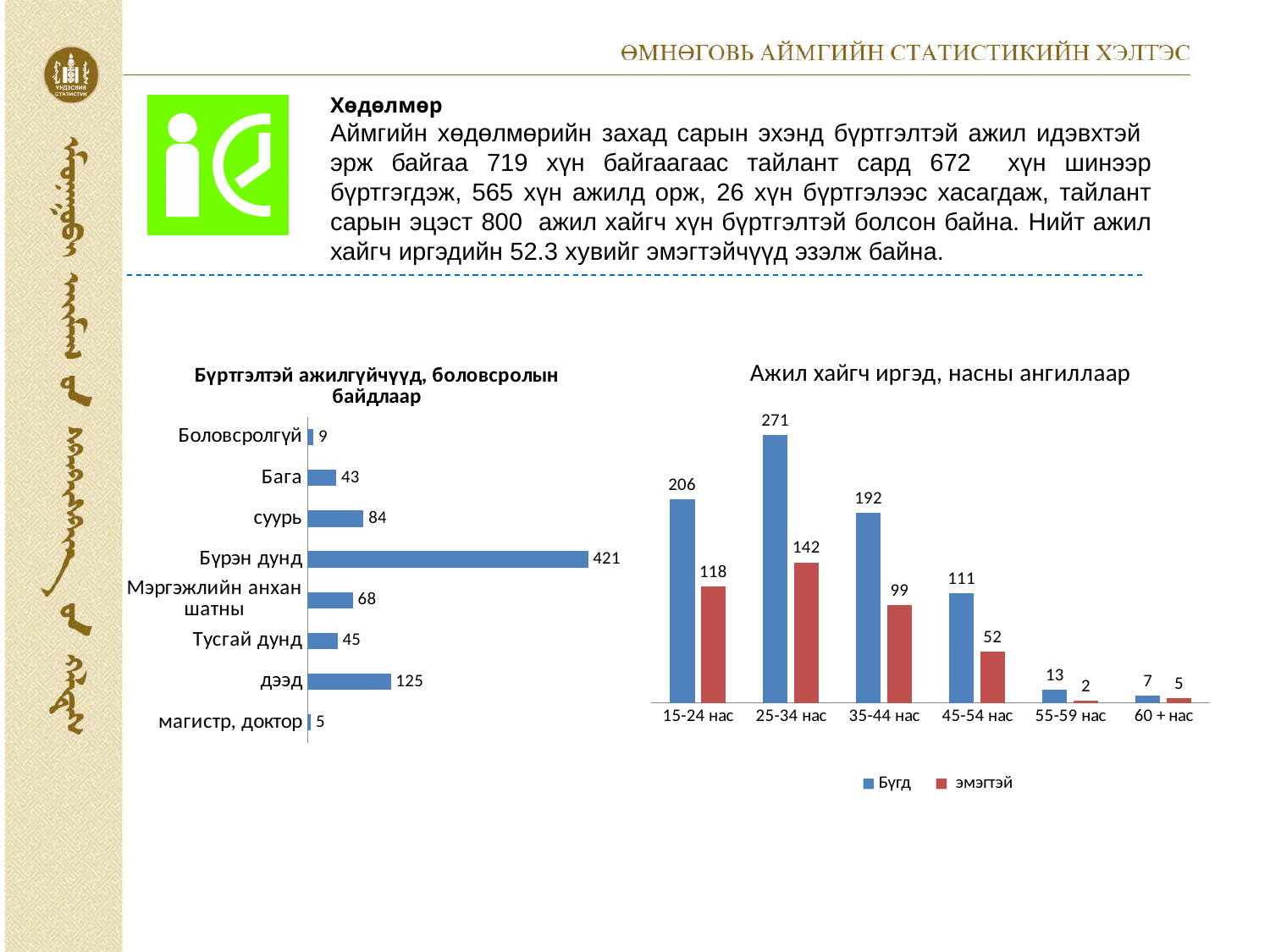
In the chart 'Бүртгэлтэй ажилгүйчүүд, боловсролын байдлаар', what is the value for Бүрэн дунд? 421 In the chart 'Бүртгэлтэй ажилгүйчүүд, боловсролын байдлаар', which category has the lowest value? магистр, доктор In the chart 'Ажил хайгч иргэд, насны ангиллаар', what colour are the эмэгтэй bars? Red In the chart 'Ажил хайгч иргэд, насны ангиллаар', what is the value of Бүгд for 25-34 нас? 271 In the chart 'Ажил хайгч иргэд, насны ангиллаар', which age group has the highest Бүгд value? 25-34 нас What kind of chart is 'Бүртгэлтэй ажилгүйчүүд, боловсролын байдлаар'? Bar chart In the chart 'Бүртгэлтэй ажилгүйчүүд, боловсролын байдлаар', what is the difference between дээд and суурь? 41 In the chart 'Ажил хайгч иргэд, насны ангиллаар', what is the difference between Бүгд and эмэгтэй for 15-24 нас? 88 In the chart 'Бүртгэлтэй ажилгүйчүүд, боловсролын байдлаар', how many categories are shown? 8 In the chart 'Ажил хайгч иргэд, насны ангиллаар', which is larger: эмэгтэй for 35-44 нас or эмэгтэй for 25-34 нас? 25-34 нас In the chart 'Ажил хайгч иргэд, насны ангиллаар', what is the value of эмэгтэй for 45-54 нас? 52 In the chart 'Ажил хайгч иргэд, насны ангиллаар', how many series does the legend list? 2